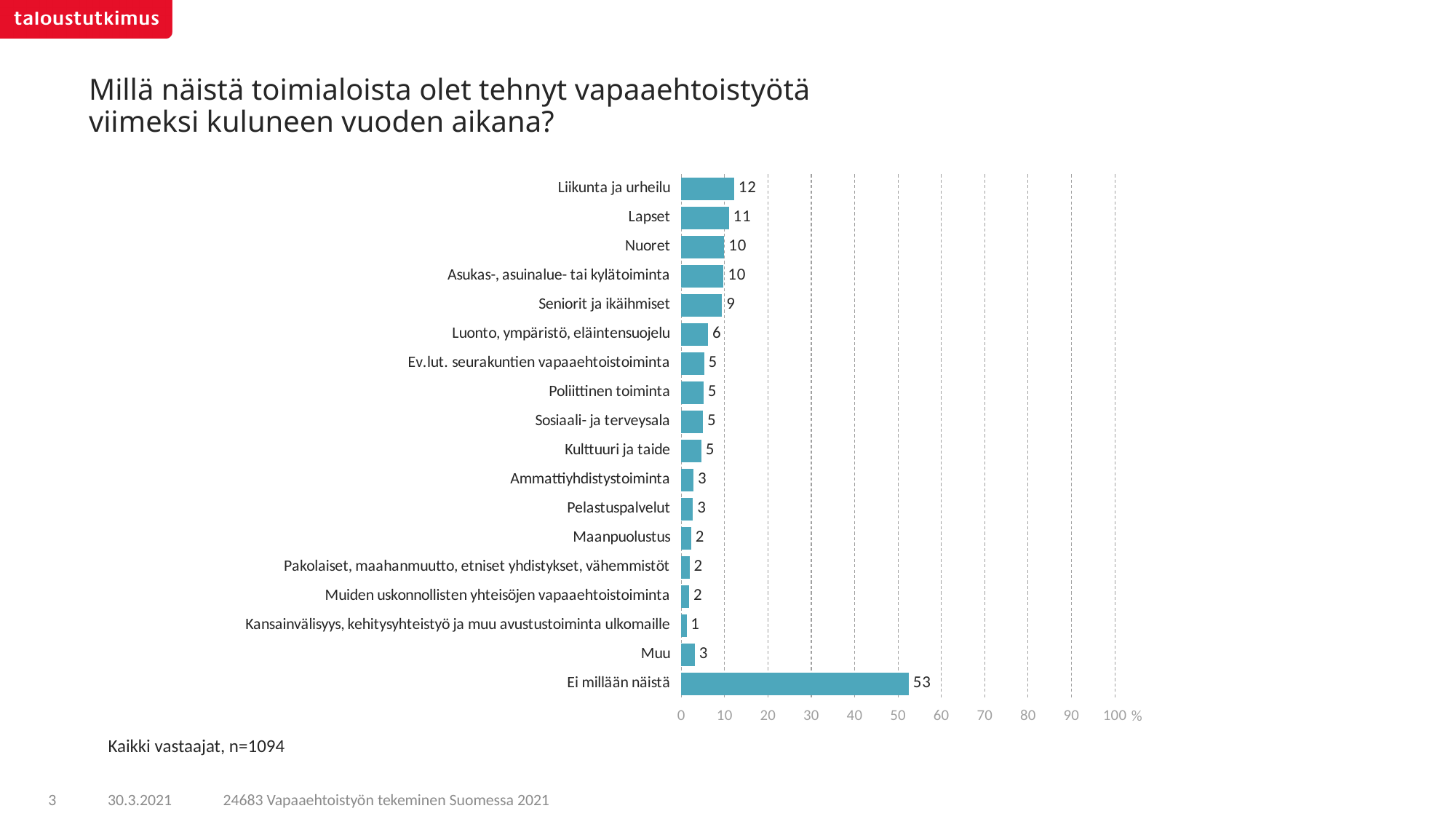
Which category has the lowest value? Kansainvälisyys, kehitysyhteistyö ja muu avustustoiminta ulkomaille What kind of chart is shown on the slide? Bar chart What is the value for Ei millään näistä? 53 What is the value for Liikunta ja urheilu? 12 How many categories are shown in the chart? 18 Is the value for Ei millään näistä greater or less than 50? greater What is the value for Luonto, ympäristö, eläintensuojelu? 6 What is the value for Seniorit ja ikäihmiset? 9 Which category has the highest value? Ei millään näistä What is the difference between the values for Lapset and Luonto, ympäristö, eläintensuojelu? 5 What is the difference between the values for Ei millään näistä and Liikunta ja urheilu? 41 Which is larger, the value for Lapset or the value for Nuoret? Lapset